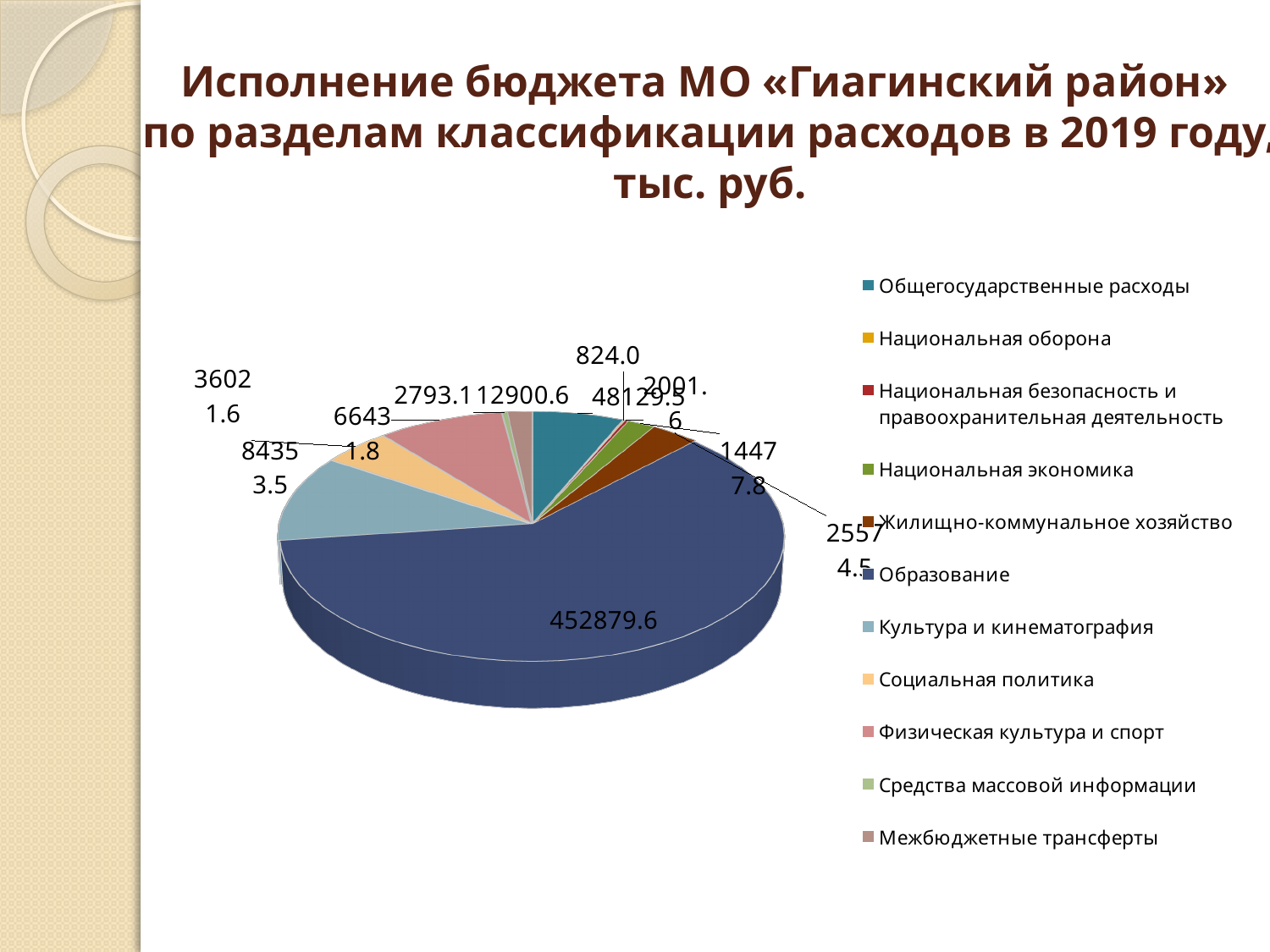
Which category is the last entry in the legend? Межбюджетные трансферты What is the title of the chart? Исполнение бюджета МО «Гиагинский район» по разделам классификации расходов в 2019 году, тыс. руб. What kind of chart is shown on the slide? pie chart How many categories does the legend list? 11 What value is shown for Образование? 452879.6 Which slice is larger, Образование or Общегосударственные расходы? Образование Which category has the largest slice of the pie? Образование Which slice is larger, Образование or Культура и кинематография? Образование